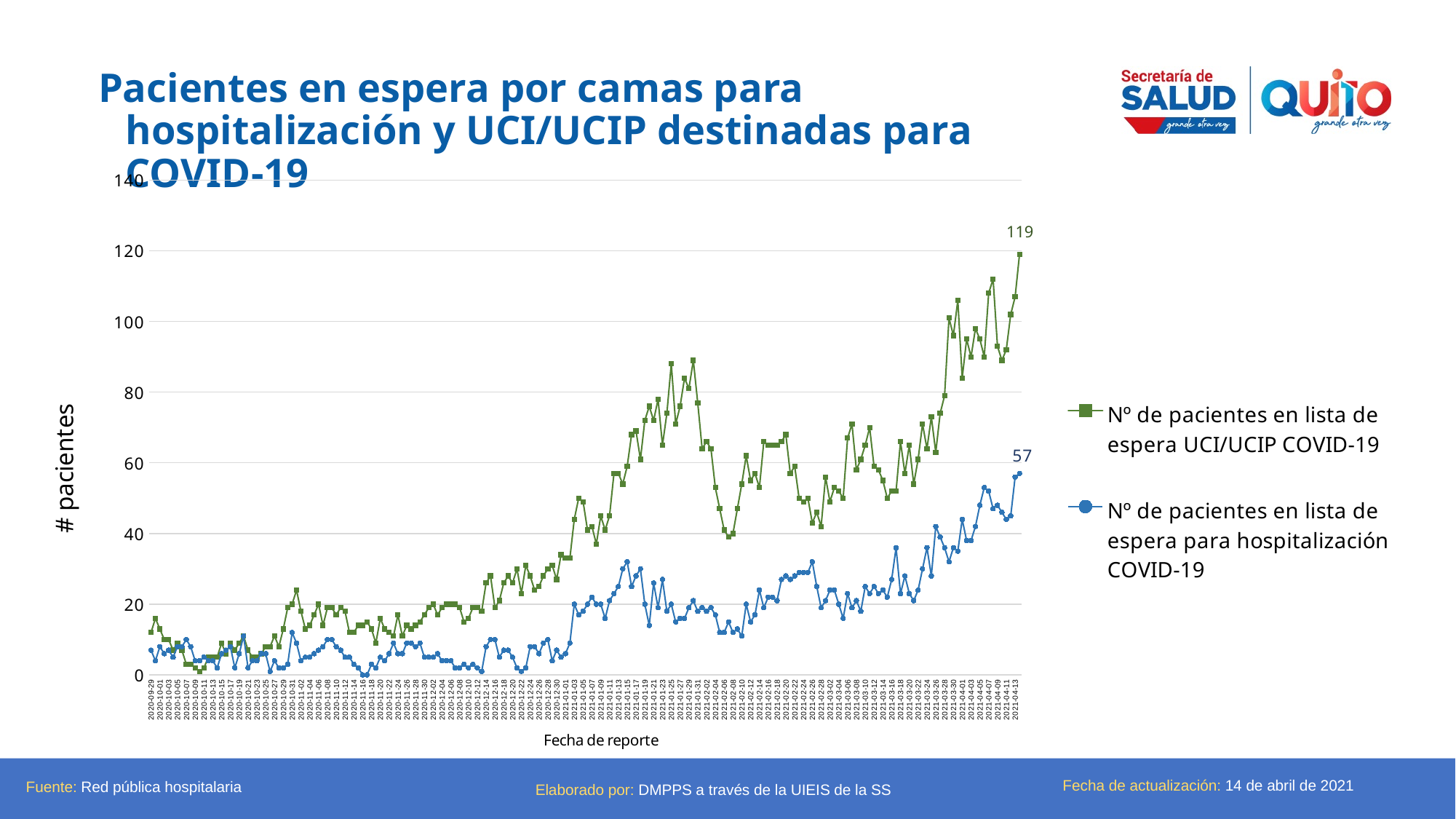
Is the final value of the hospitalización series greater or less than 60? less Is the final value of the UCI/UCIP series greater or less than 100? greater Which series reaches the highest value on the chart? Nº de pacientes en lista de espera UCI/UCIP COVID-19 What is the last labelled value of the series 'Nº de pacientes en lista de espera para hospitalización COVID-19'? 57 Do the values of the UCI/UCIP series generally rise or fall from left to right along the x axis? rise What is the title of the y axis? # pacientes What kind of chart is shown on the slide? line chart What is the last labelled value of the series 'Nº de pacientes en lista de espera UCI/UCIP COVID-19'? 119 What is the last date shown on the x axis? 2021-04-13 How many series does the legend list? 2 At the final date, which series has the larger value: UCI/UCIP or hospitalización? Nº de pacientes en lista de espera UCI/UCIP COVID-19 What is the difference between the final labelled values of the UCI/UCIP series (119) and the hospitalización series (57)? 62